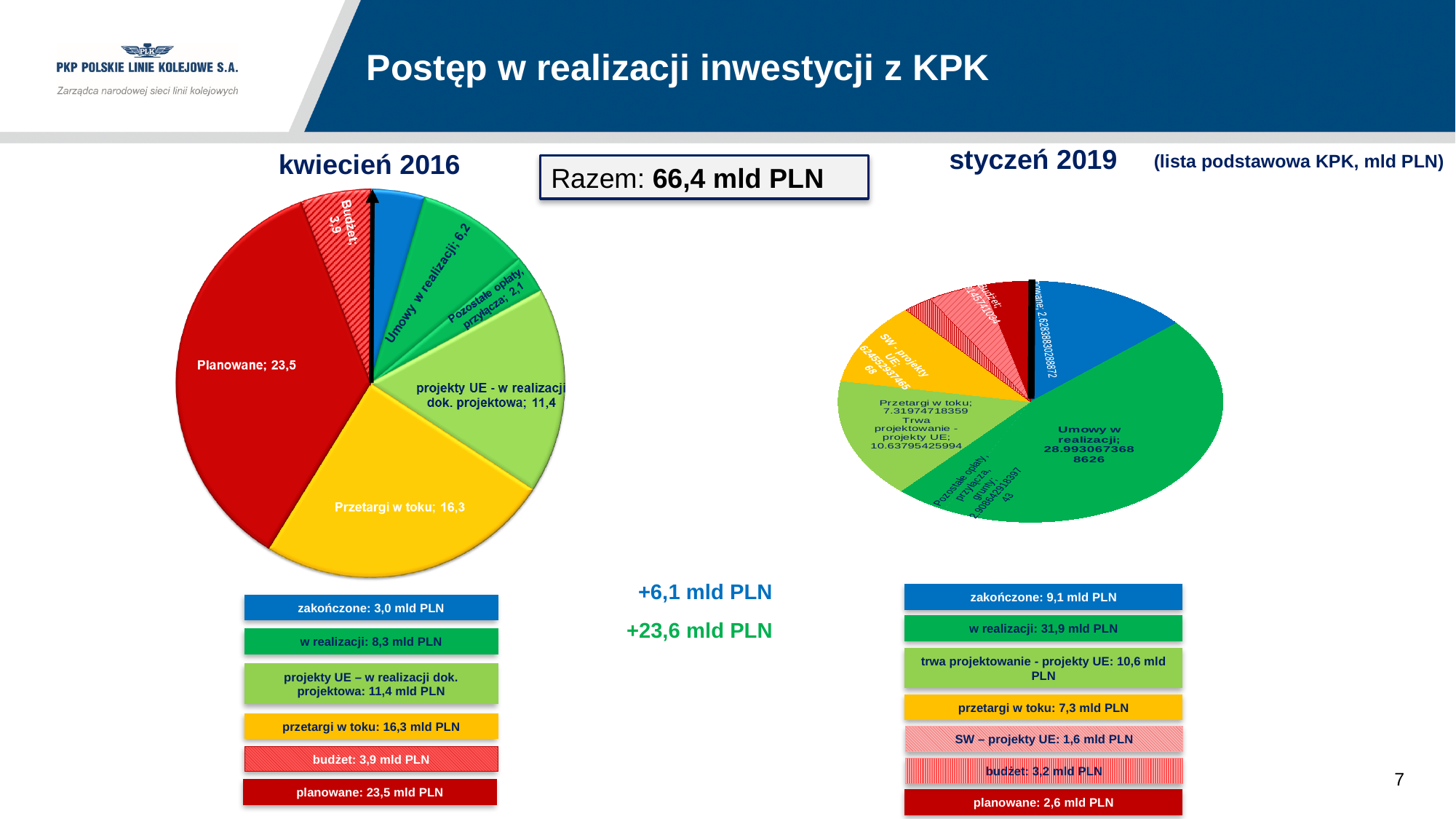
How many slices does the kwiecień 2016 pie chart have? 7 On the kwiecień 2016 pie chart, which is larger: Przetargi w toku or projekty UE - w realizacji dok. projektowa? Przetargi w toku On the kwiecień 2016 pie chart, what is the value for Umowy w realizacji? 6,2 On the kwiecień 2016 pie chart, what is the value for Przetargi w toku? 16,3 On the kwiecień 2016 pie chart, which labelled category has the smallest value? Pozostałe opłaty, przyłącza On the kwiecień 2016 pie chart, what is the difference between Planowane and Przetargi w toku? 7,2 On the kwiecień 2016 pie chart, what is the value for Budżet? 3,9 On the styczeń 2019 pie chart, which category has the largest slice? Umowy w realizacji On the styczeń 2019 pie chart, which is larger: Umowy w realizacji or Trwa projektowanie - projekty UE? Umowy w realizacji On the kwiecień 2016 pie chart, which category has the largest slice? Planowane On the kwiecień 2016 pie chart, what is the value for Planowane? 23,5 What type of chart is used for kwiecień 2016? Pie chart